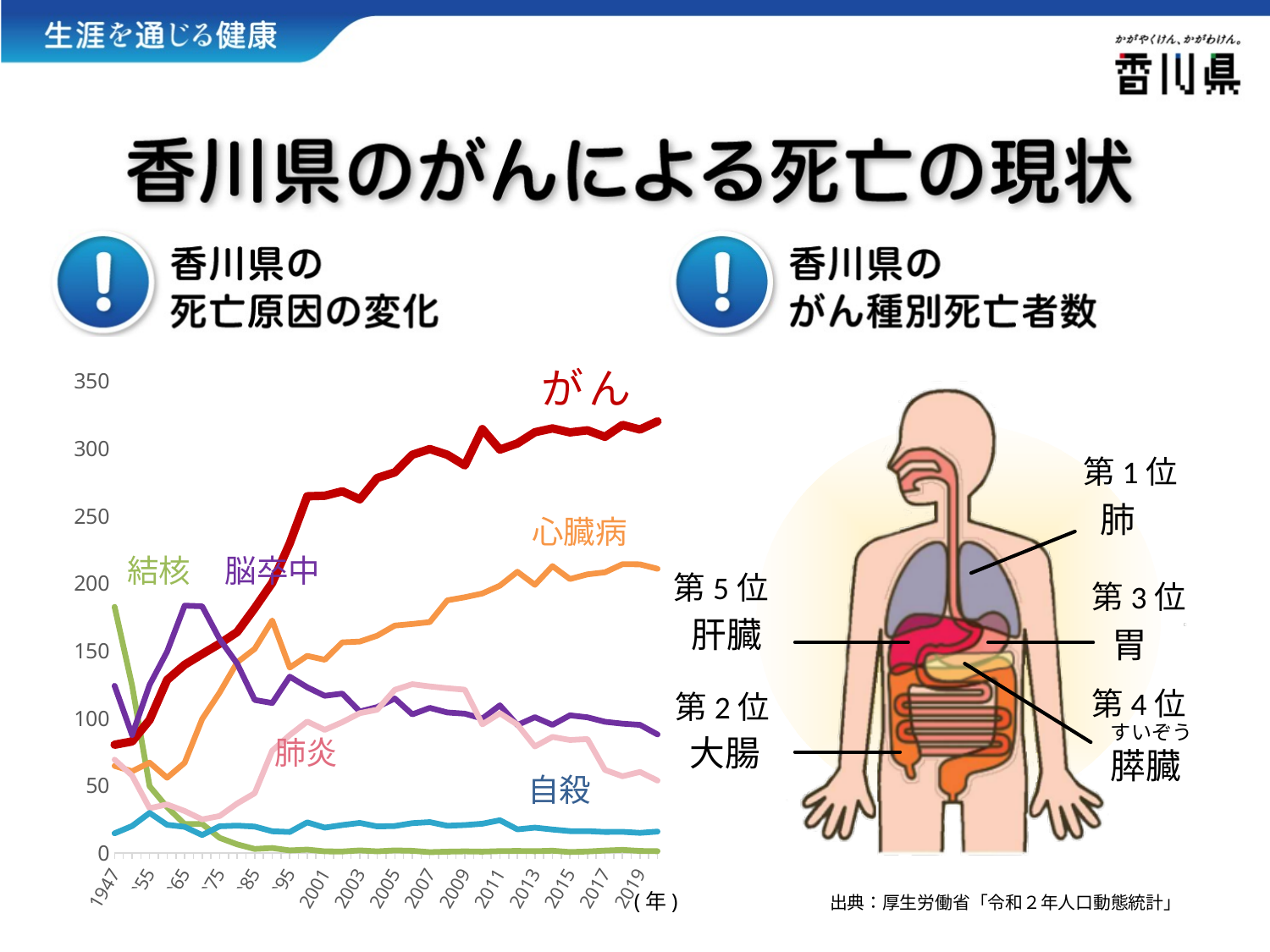
In the 香川県の死亡原因の変化 chart, is the value for 心臓病 in 2019 greater or less than 250? less In the 香川県の死亡原因の変化 chart, is the value for がん in 2019 greater or less than 300? greater In the 香川県の死亡原因の変化 chart, does the 結核 line rise or fall from 1947 to 2019? fall In the 香川県の死亡原因の変化 chart, which cause of death has the lowest value in 2019? 結核 How many causes of death are plotted as lines in the 香川県の死亡原因の変化 chart? 6 In the 香川県の死亡原因の変化 chart, is the value for 結核 in 1947 greater or less than 150? greater In the 香川県の死亡原因の変化 chart, which cause of death has the highest value in 2019? がん What kind of chart is used to show 香川県の死亡原因の変化? line chart In the 香川県の死亡原因の変化 chart, what colour is the がん line? red In the 香川県の死亡原因の変化 chart, which is larger in 2019, 脳卒中 or 肺炎? 脳卒中 In the 香川県の死亡原因の変化 chart, which cause of death has the highest value in 1947? 結核